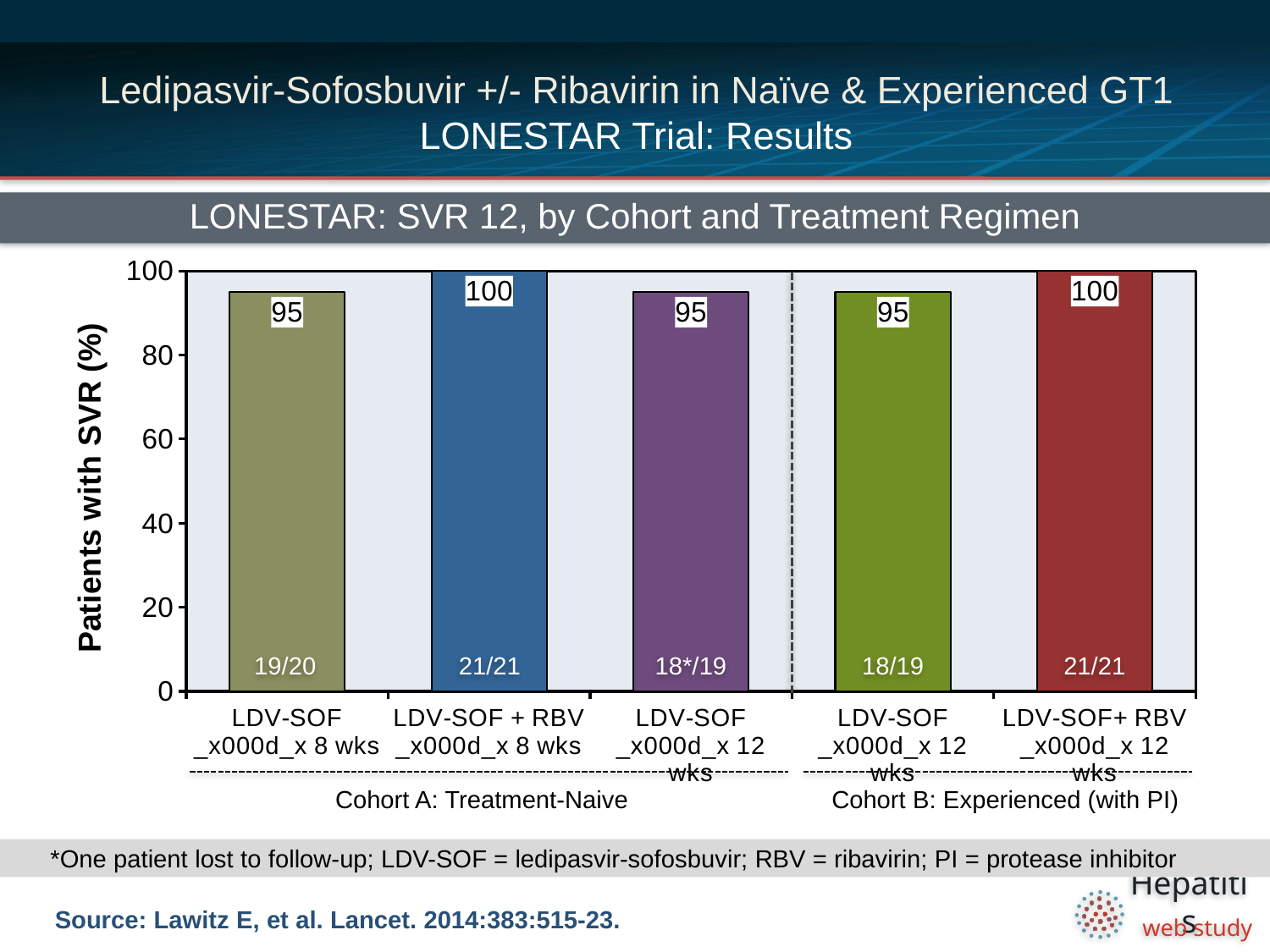
What type of chart is shown on the slide? Bar chart What is the SVR 12 value for LDV-SOF + RBV x 12 wks in Cohort B (Experienced with PI)? 100 How many bars are plotted in the chart? 5 Which is larger: the SVR 12 for LDV-SOF x 12 wks in Cohort A or for LDV-SOF + RBV x 12 wks in Cohort B? LDV-SOF + RBV x 12 wks in Cohort B Is the SVR 12 value for LDV-SOF x 12 wks in Cohort A greater or less than 80? greater What is the label of the y-axis? Patients with SVR (%) What is the SVR 12 value for LDV-SOF x 8 wks in Cohort A (Treatment-Naive)? 95 What is the difference in SVR 12 between LDV-SOF + RBV x 8 wks and LDV-SOF x 8 wks in Cohort A? 5 What patient fraction is shown inside the bar for LDV-SOF x 8 wks in Cohort A (Treatment-Naive)? 19/20 What is the title of the chart? LONESTAR: SVR 12, by Cohort and Treatment Regimen What is the SVR 12 value for LDV-SOF + RBV x 8 wks in Cohort A (Treatment-Naive)? 100 What patient fraction is shown inside the bar for LDV-SOF x 12 wks in Cohort B (Experienced with PI)? 18/19